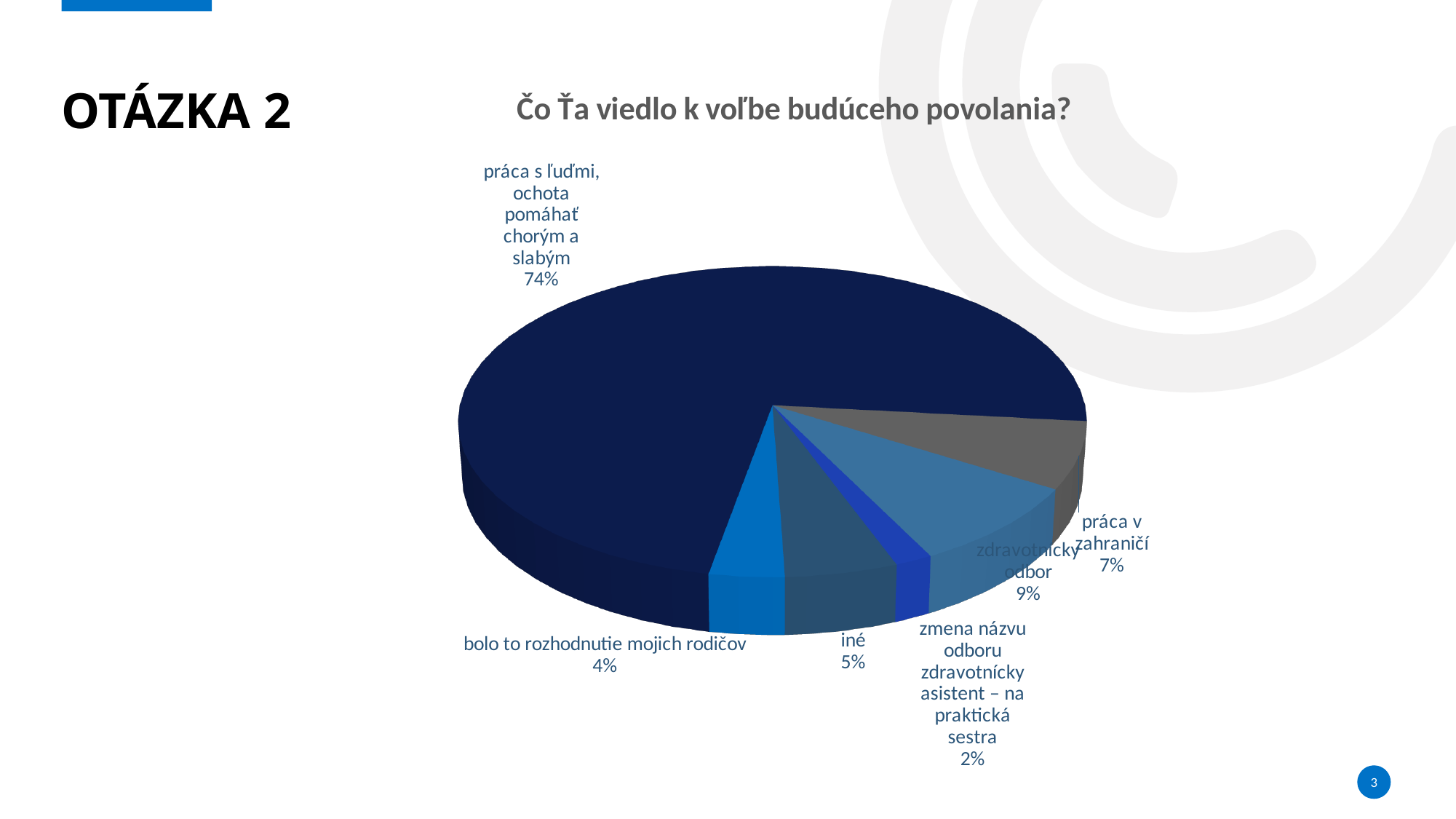
What share of the pie is 'iné'? 5% Which category has the largest slice of the pie? práca s ľuďmi, ochota pomáhať chorým a slabým What kind of chart is shown on the slide? pie chart What is the title of the chart? Čo Ťa viedlo k voľbe budúceho povolania? What share of the pie is 'bolo to rozhodnutie mojich rodičov'? 4% What is the difference in percentage points between 'práca s ľuďmi, ochota pomáhať chorým a slabým' and 'zdravotnícky odbor'? 65 percentage points Which is larger: the slice for 'zdravotnícky odbor' or the slice for 'práca v zahraničí'? zdravotnícky odbor What share of the pie is 'práca s ľuďmi, ochota pomáhať chorým a slabým'? 74% Which category has the smallest slice of the pie? zmena názvu odboru zdravotnícky asistent – na praktická sestra How many slices does the pie chart have? 6